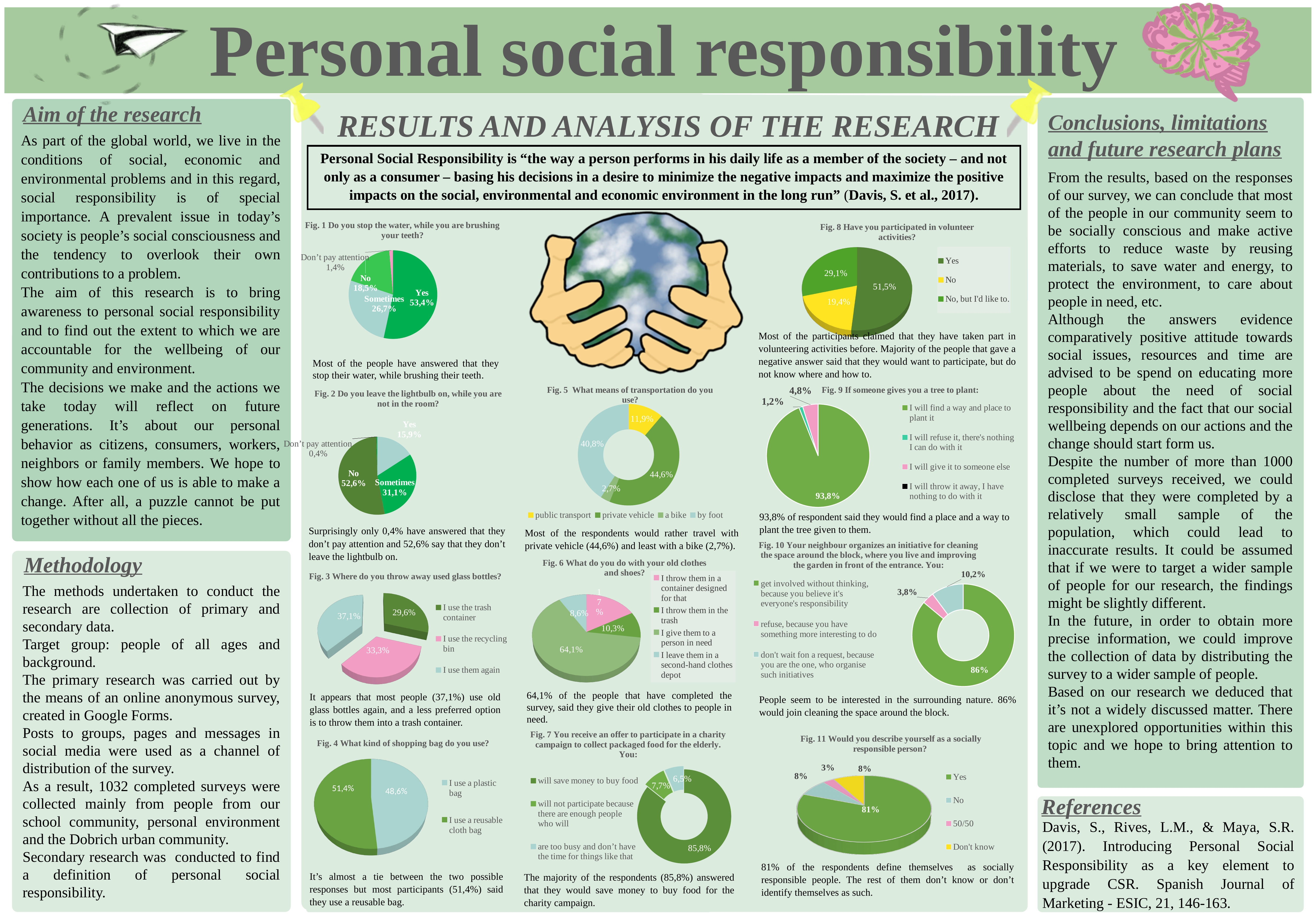
In Fig. 2 (Do you leave the lightbulb on, while you are not in the room?), which answer has the largest share? No In Fig. 6 (What do you do with your old clothes and shoes?), what percentage said "I throw them in the trash"? 10,3% In Fig. 4 (What kind of shopping bag do you use?), which is larger: "I use a plastic bag" or "I use a reusable cloth bag"? I use a reusable cloth bag In Fig. 11 (Would you describe yourself as a socially responsible person?), what is the combined share of "No" and "Don't know"? 16% In Fig. 10 (Your neighbour organizes an initiative for cleaning the space around the block...), what is the share for "refuse, because you have something more interesting to do"? 3,8% In Fig. 5 (What means of transportation do you use?), how many categories does the legend list? 4 In Fig. 8 (Have you participated in volunteer activities?), what percentage answered "No, but I'd like to"? 29,1% In Fig. 3 (Where do you throw away used glass bottles?), what is the difference between "I use them again" and "I use the trash container"? 7,5% In Fig. 5 (What means of transportation do you use?), which category has the smallest share? a bike In Fig. 7 (You receive an offer to participate in a charity campaign...), what kind of chart is shown? Doughnut chart In Fig. 1 (Do you stop the water, while you are brushing your teeth?), what percentage answered "Yes"? 53,4% In Fig. 9 (If someone gives you a tree to plant), what percentage said "I will give it to someone else"? 4,8%